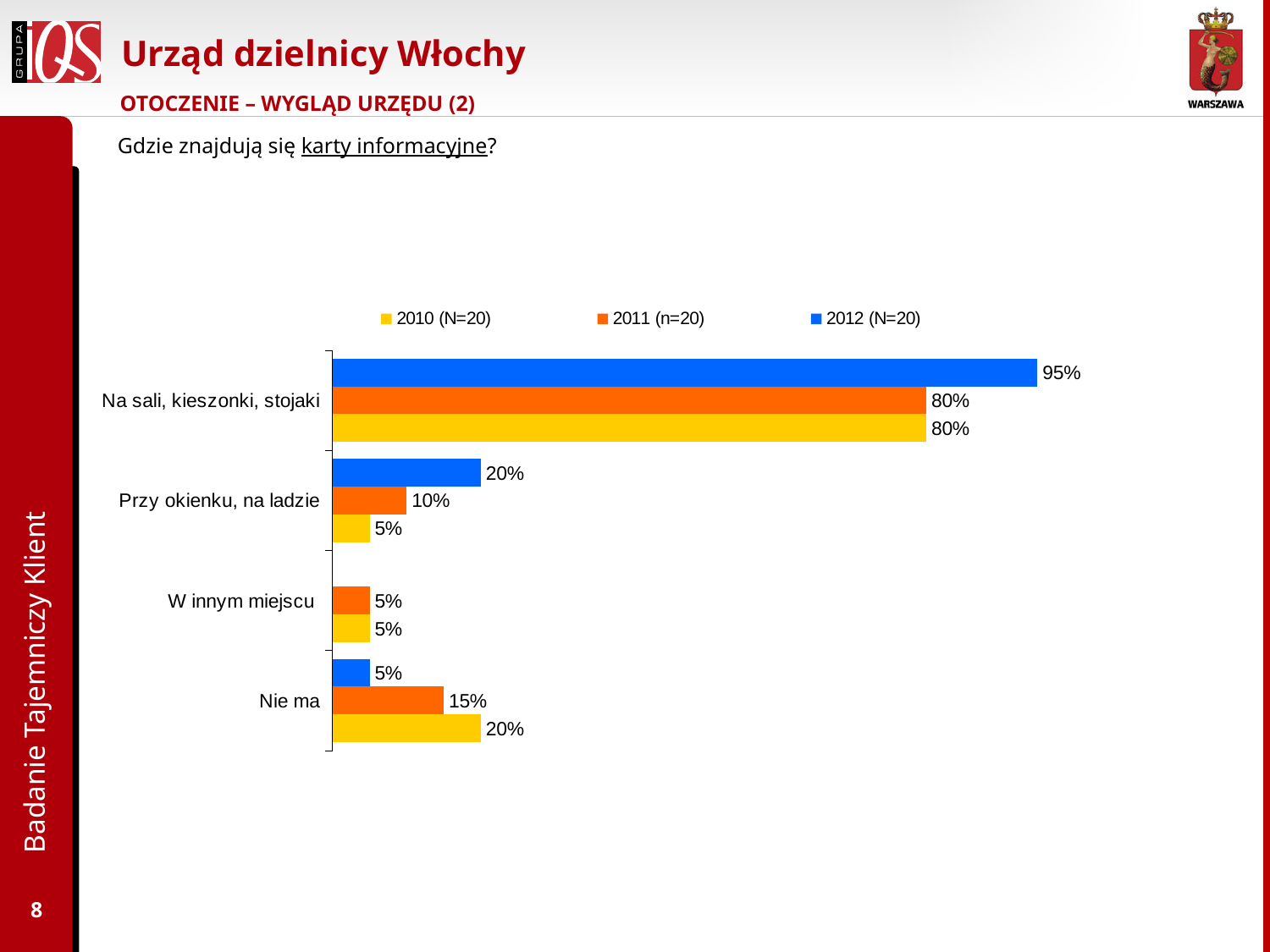
Which category has the lowest value in the 2011 (n=20) series? W innym miejscu What kind of chart is shown on the slide? Bar chart How many categories are shown on the chart? 4 Which category has the highest value in the 2012 (N=20) series? Na sali, kieszonki, stojaki What is the value for 'Przy okienku, na ladzie' in the 2011 (n=20) series? 10% What is the difference between the 2010 (N=20) and 2012 (N=20) values for 'Nie ma'? 15% Which colour represents the 2012 (N=20) series in the legend? Blue Which is larger for 'Nie ma': the 2010 (N=20) value or the 2012 (N=20) value? 2010 (N=20) What is the difference between the 2012 (N=20) and 2011 (n=20) values for 'Na sali, kieszonki, stojaki'? 15% How many series does the legend list? 3 What is the value for 'Na sali, kieszonki, stojaki' in the 2012 (N=20) series? 95% What is the value for 'Nie ma' in the 2010 (N=20) series? 20%